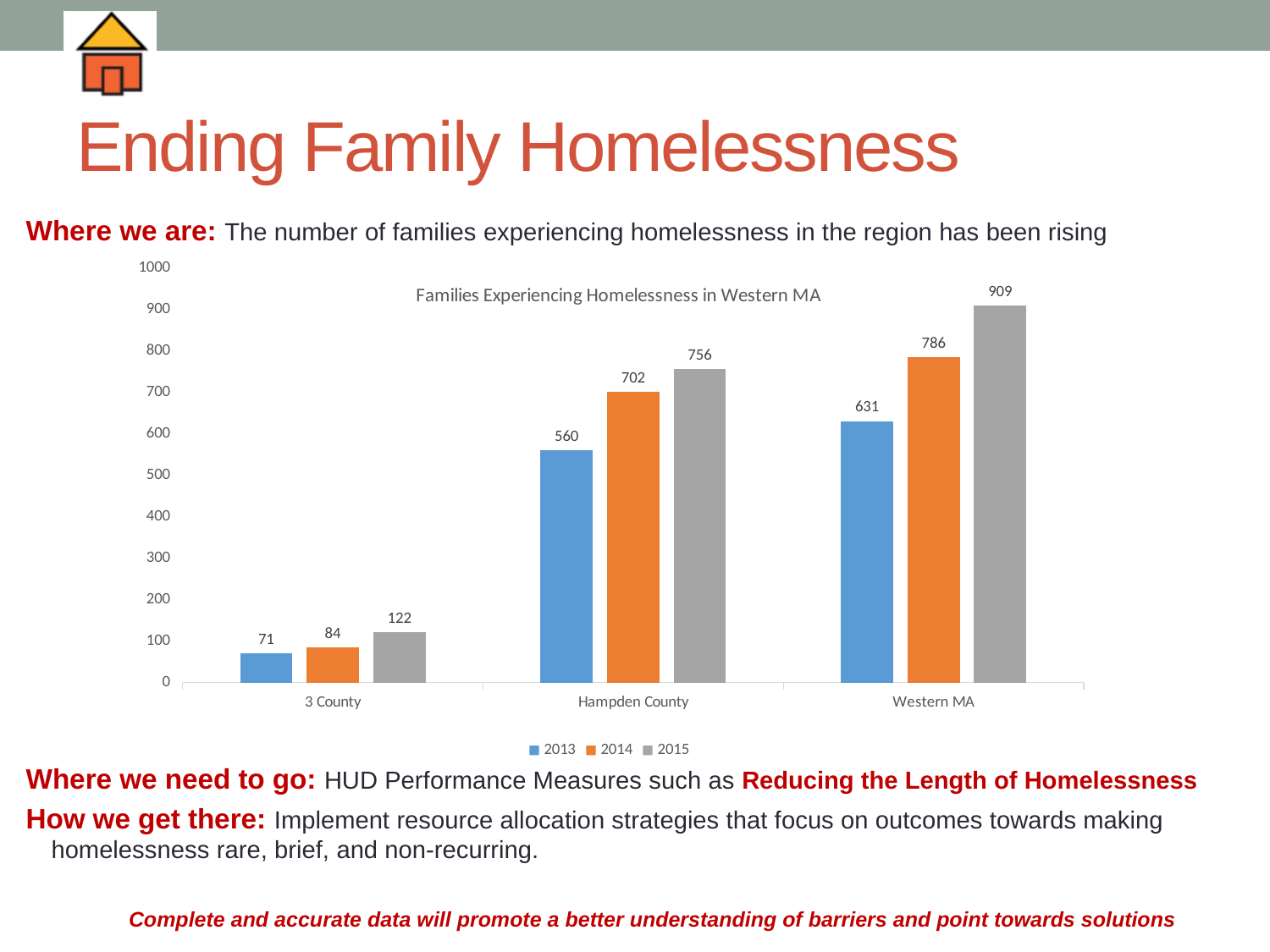
Which category has the lowest value in 2013? 3 County What is the value for 3 County in 2013? 71 What is the value for Western MA in 2015? 909 Which category has the highest value in 2015? Western MA What is the difference between the 2015 and 2013 values for Hampden County? 196 What is the value for Hampden County in 2014? 702 How many categories are shown on the x axis? 3 Which is larger: the 2014 value for Western MA or the 2015 value for Hampden County? 2014 value for Western MA How many series does the legend list? 3 What is the title of the chart? Families Experiencing Homelessness in Western MA Is the value for Western MA in 2013 greater or less than 600? greater What kind of chart is shown on the slide? bar chart